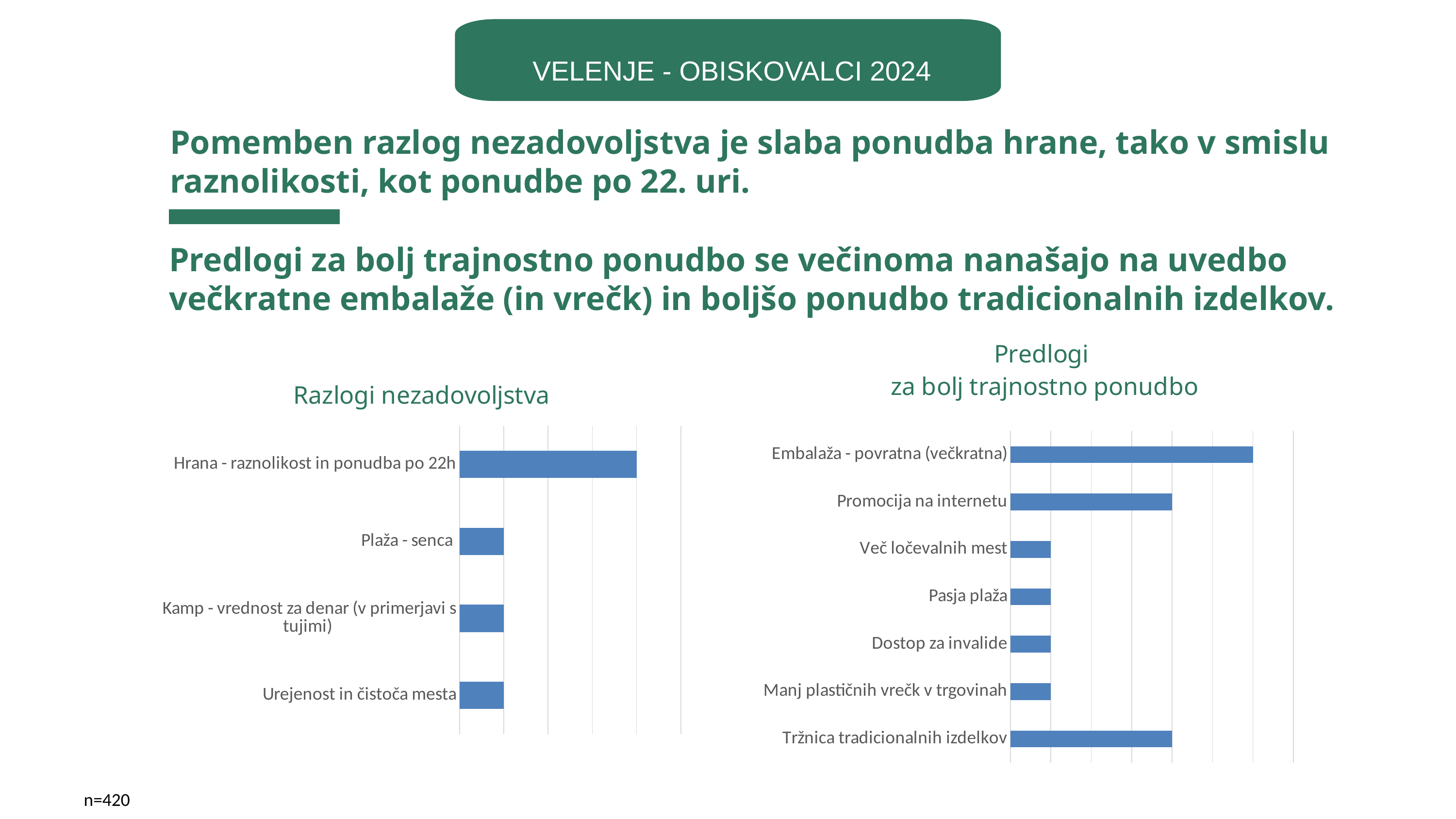
In the 'Predlogi za bolj trajnostno ponudbo' chart, which category has the highest value? Embalaža - povratna (večkratna) How many charts are shown on the slide? 2 What kind of chart is the 'Razlogi nezadovoljstva' chart? bar chart In the 'Razlogi nezadovoljstva' chart, which category has the highest value? Hrana - raznolikost in ponudba po 22h How many categories are shown in the 'Razlogi nezadovoljstva' chart? 4 What is the title of the chart on the left side of the slide? Razlogi nezadovoljstva How many categories are shown in the 'Predlogi za bolj trajnostno ponudbo' chart? 7 In the 'Predlogi za bolj trajnostno ponudbo' chart, which is larger: 'Tržnica tradicionalnih izdelkov' or 'Dostop za invalide'? Tržnica tradicionalnih izdelkov In the 'Predlogi za bolj trajnostno ponudbo' chart, which is larger: 'Promocija na internetu' or 'Pasja plaža'? Promocija na internetu What kind of chart is the 'Predlogi za bolj trajnostno ponudbo' chart? bar chart In the 'Predlogi za bolj trajnostno ponudbo' chart, which is larger: 'Embalaža - povratna (večkratna)' or 'Promocija na internetu'? Embalaža - povratna (večkratna)